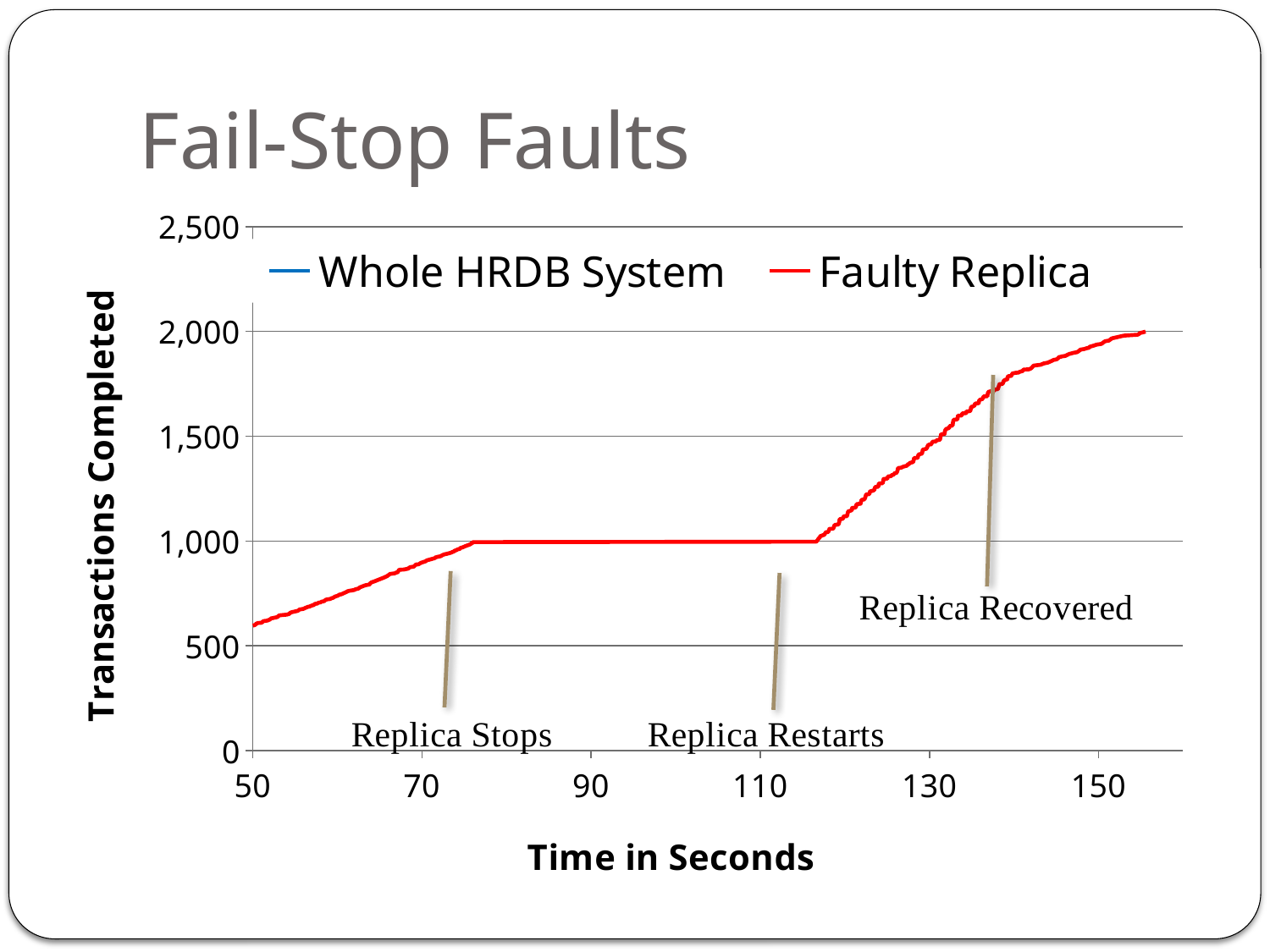
How many series does the legend list? 2 Is the value of the Faulty Replica line at 140 seconds greater or less than 1,500? greater What kind of chart is shown on the slide? line chart Is the value of the Faulty Replica line at 70 seconds greater or less than 1,000? less Which is larger for the Faulty Replica line: the value at 60 seconds or the value at 130 seconds? 130 seconds Is the value of the Faulty Replica line at 120 seconds greater or less than 1,000? greater Does the Faulty Replica line rise or fall between 120 and 150 seconds? rise What is the label of the y axis? Transactions Completed What is the title of the slide containing the chart? Fail-Stop Faults At what value does the Faulty Replica line stay flat between roughly 80 and 110 seconds? 1,000